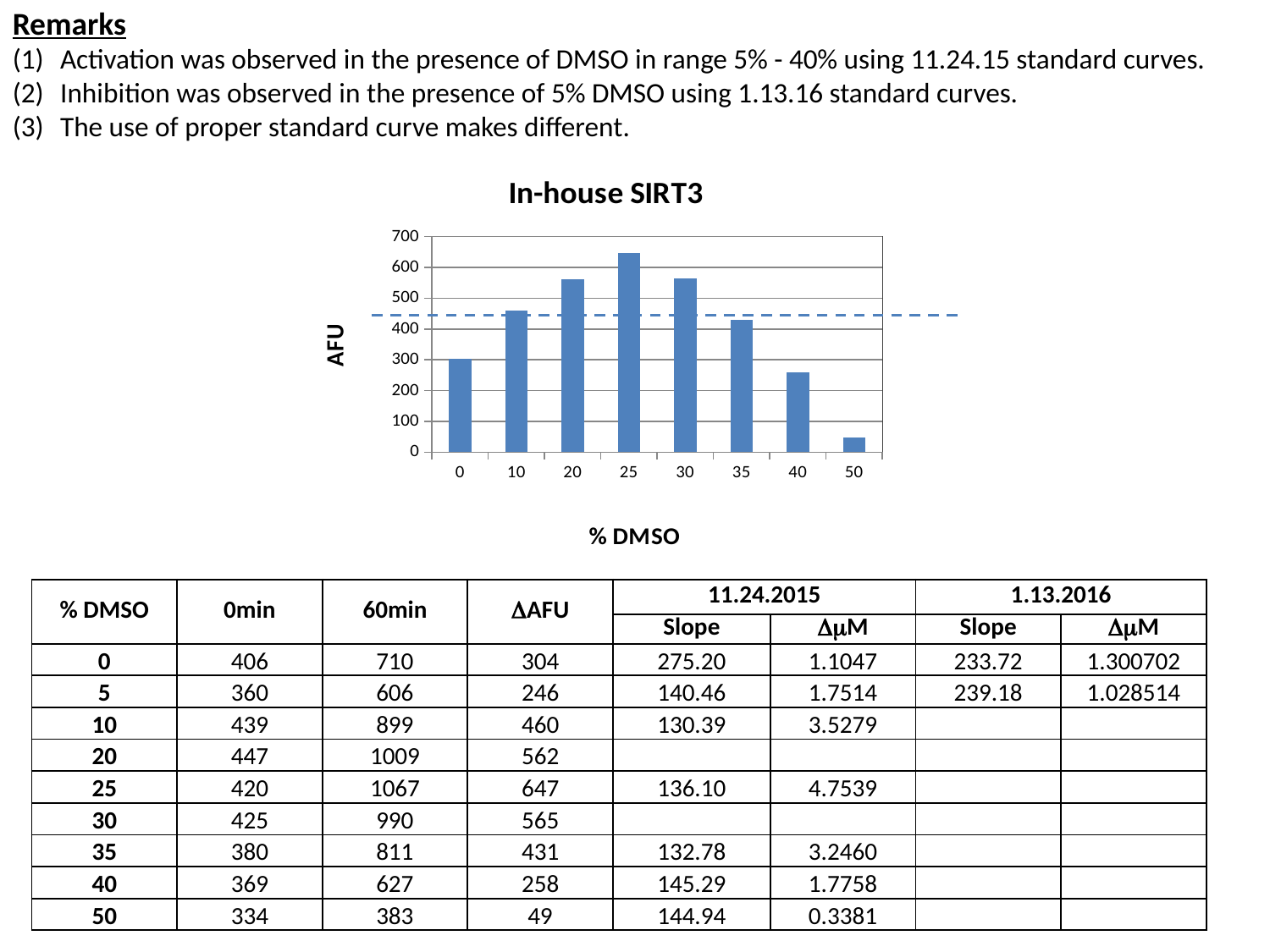
What is the title of the chart? In-house SIRT3 Is the AFU value for 20% DMSO greater or less than 500? greater Which % DMSO category has the highest AFU bar? 25 Which % DMSO category has the lowest AFU bar? 50 Is the AFU value for 0% DMSO greater or less than 400? less Which has the larger AFU bar, 10% DMSO or 40% DMSO? 10 Is the AFU value for 50% DMSO greater or less than 100? less How many bars (% DMSO categories) are plotted in the chart? 8 What is the label of the y-axis of the chart? AFU What type of chart is shown on the slide? bar chart Do the AFU bars rise or fall as % DMSO goes from 25 to 50? fall